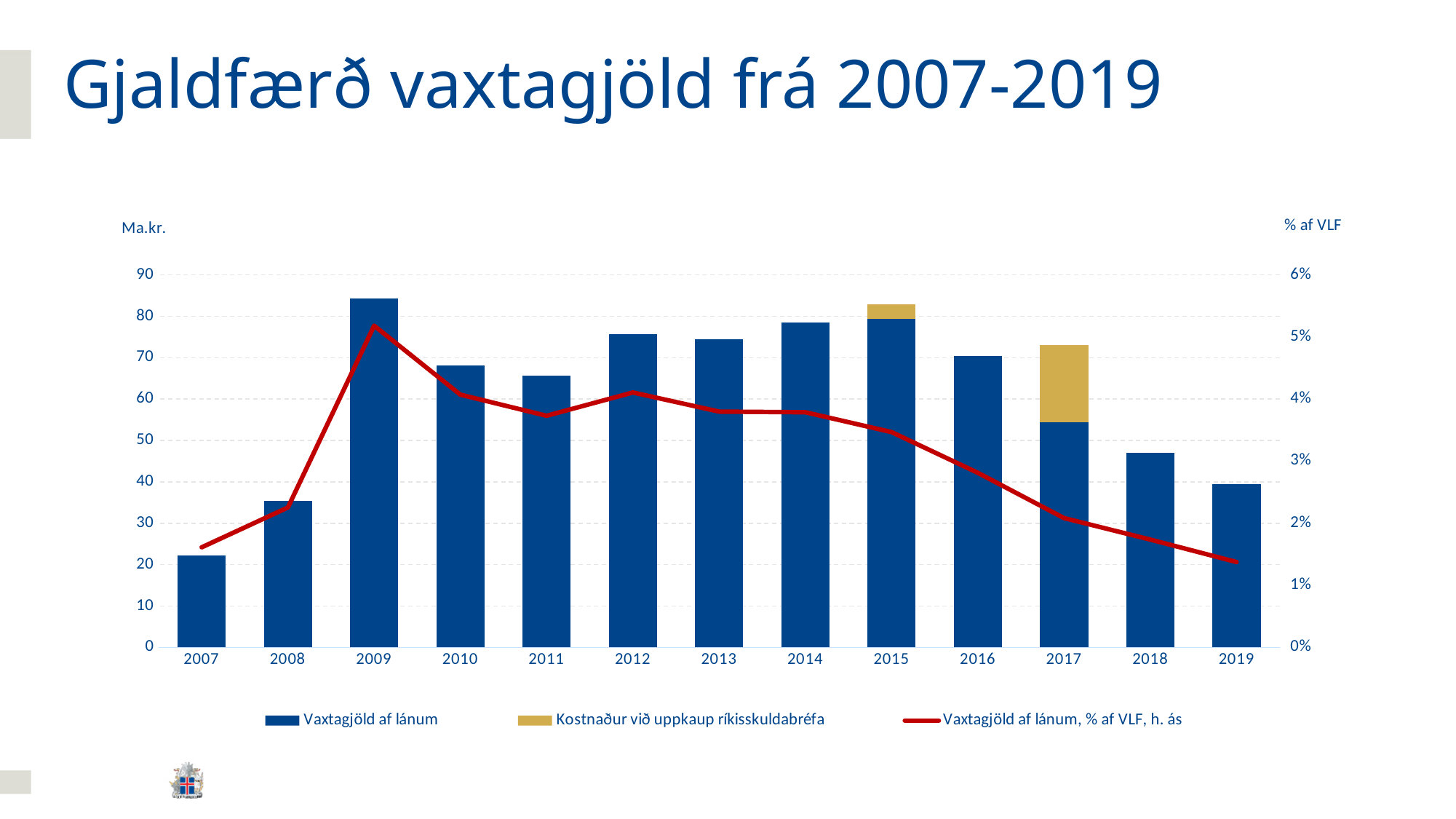
In which years does the chart show a gold segment for Kostnaður við uppkaup ríkisskuldabréfa? 2015 and 2017 Which year has a taller Vaxtagjöld af lánum bar, 2014 or 2016? 2014 Which year has the shortest bar for Vaxtagjöld af lánum? 2007 Is the Vaxtagjöld af lánum bar for 2018 greater or less than 40 Ma.kr.? greater Is the Vaxtagjöld af lánum bar for 2007 greater or less than 30 Ma.kr.? less How many years are shown along the x axis of the chart? 13 Which year has the tallest bar for Vaxtagjöld af lánum? 2009 Is the red line value (Vaxtagjöld af lánum, % af VLF) for 2019 greater or less than 2%? less Does the red line (Vaxtagjöld af lánum, % af VLF) rise or fall from 2009 to 2019? Fall How many series does the chart legend list? 3 What kind of chart is shown on the slide? A bar chart with a line series